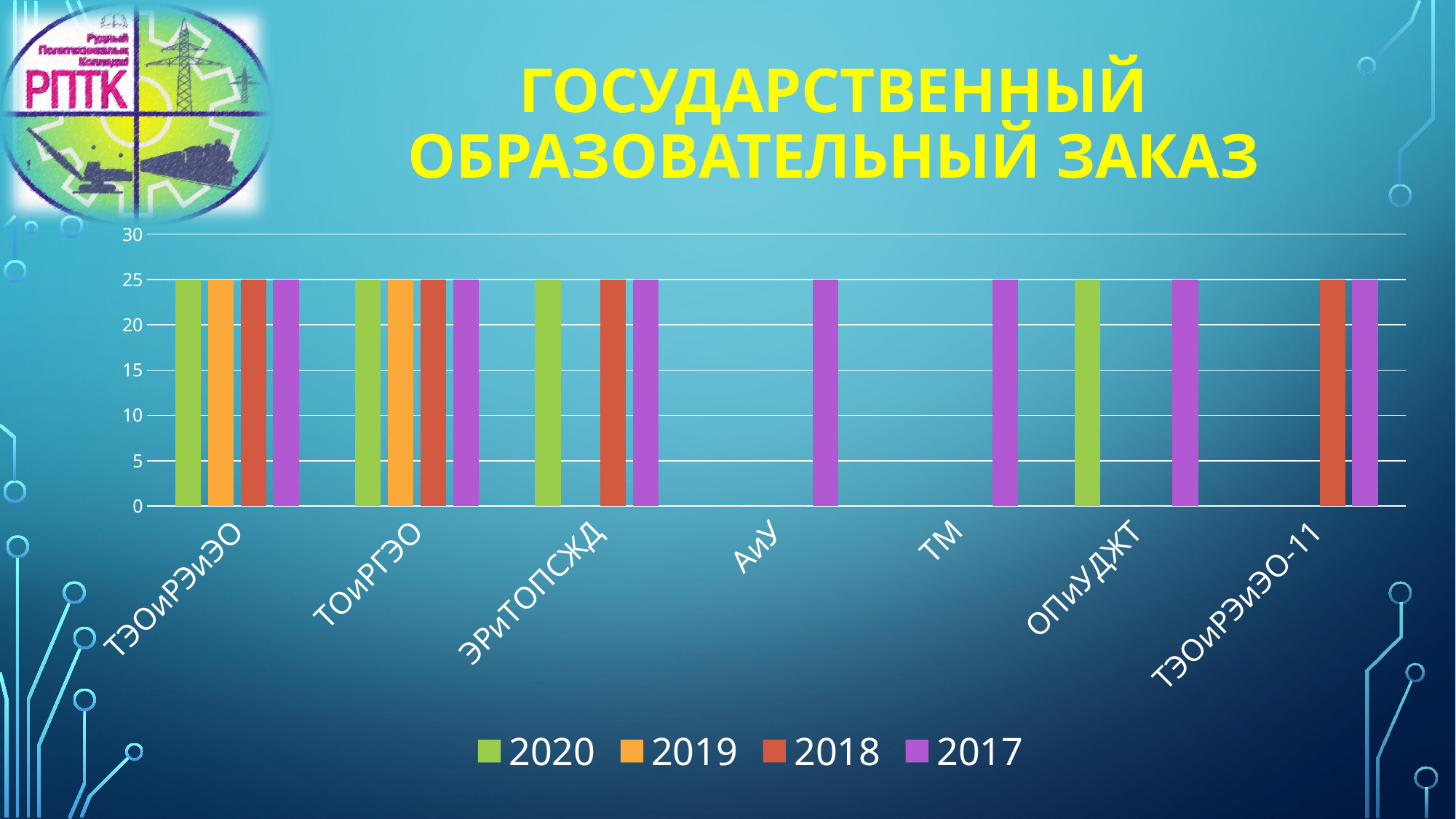
What is the title of the slide above the chart? ГОСУДАРСТВЕННЫЙ ОБРАЗОВАТЕЛЬНЫЙ ЗАКАЗ What kind of chart is shown on the slide? bar chart What is the value for ТЭОиРЭиЭО in 2020? 25 What is the difference between the 2019 value for ТОиРГЭО and the 2018 value for ТОиРГЭО? 0 How many categories are shown on the x axis? 7 What is the value for ТЭОиРЭиЭО-11 in 2018? 25 Is the value for ТМ in 2017 greater or less than 20? greater How many series does the legend list? 4 What is the value for ОПиУДЖТ in 2020? 25 What is the value for ЭРиТОПСЖД in 2018? 25 Which series is shown in purple in the legend? 2017 What is the value for АиУ in 2017? 25